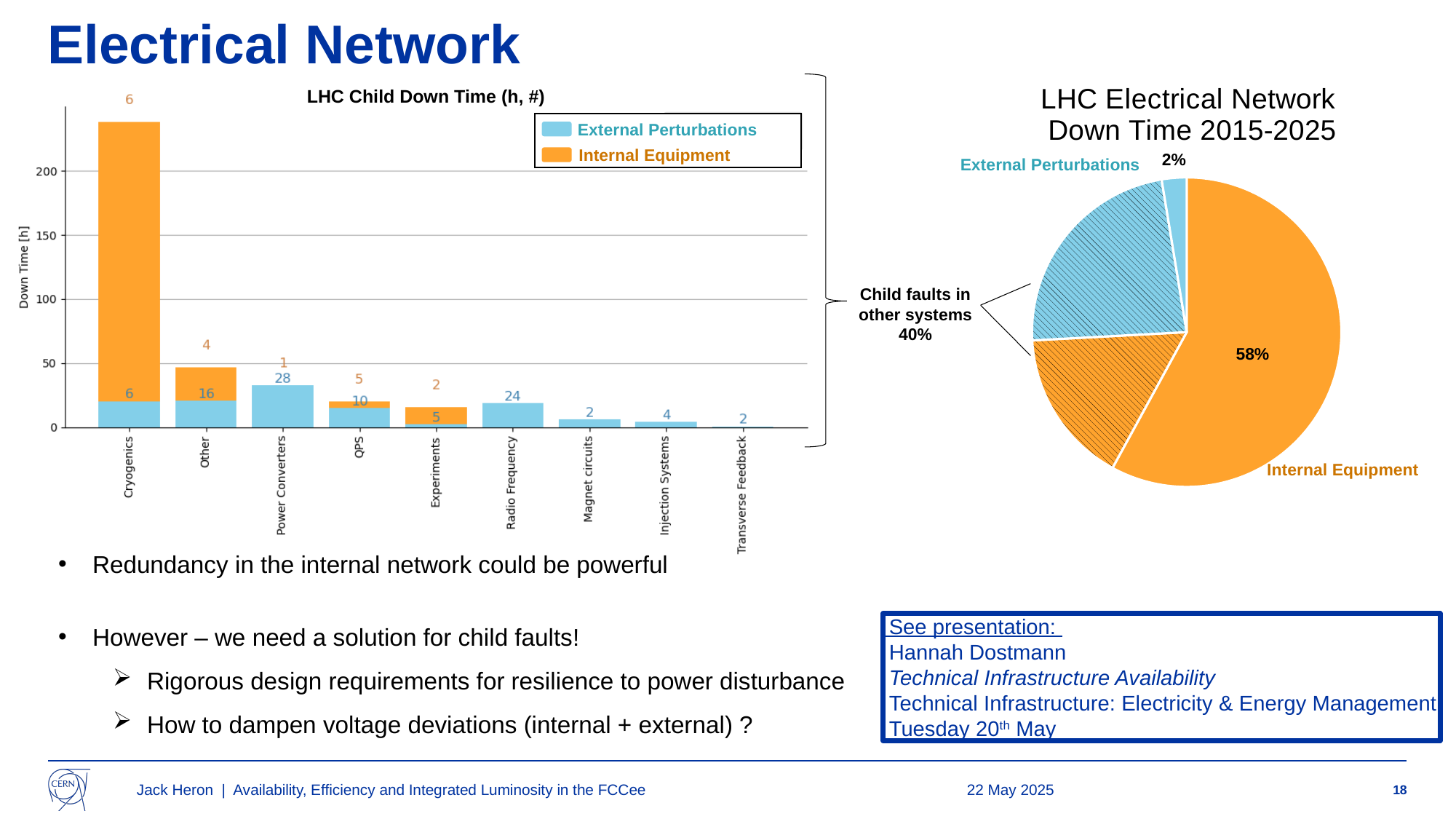
In the 'LHC Child Down Time (h, #)' bar chart, which category has the highest total down time? Cryogenics In the 'LHC Child Down Time (h, #)' bar chart, which category has the lowest total down time? Transverse Feedback In the 'LHC Electrical Network Down Time 2015-2025' pie chart, what share is labelled for Child faults in other systems? 40% In the 'LHC Child Down Time (h, #)' bar chart, is the total down time for Cryogenics greater or less than 200 hours? greater In the 'LHC Child Down Time (h, #)' bar chart, how many categories are shown on the x axis? 9 In the 'LHC Electrical Network Down Time 2015-2025' pie chart, which slice is the smallest? External Perturbations In the 'LHC Electrical Network Down Time 2015-2025' pie chart, what share is labelled for Internal Equipment? 58% In the 'LHC Child Down Time (h, #)' bar chart, how many series does the legend list? 2 In the 'LHC Child Down Time (h, #)' bar chart, is the total down time for Other greater or less than 50 hours? less What kind of chart is the 'LHC Electrical Network Down Time 2015-2025' chart on the right? pie chart What kind of chart is the 'LHC Child Down Time (h, #)' chart on the left? bar chart In the 'LHC Child Down Time (h, #)' bar chart, which has the larger total down time, Power Converters or Radio Frequency? Power Converters